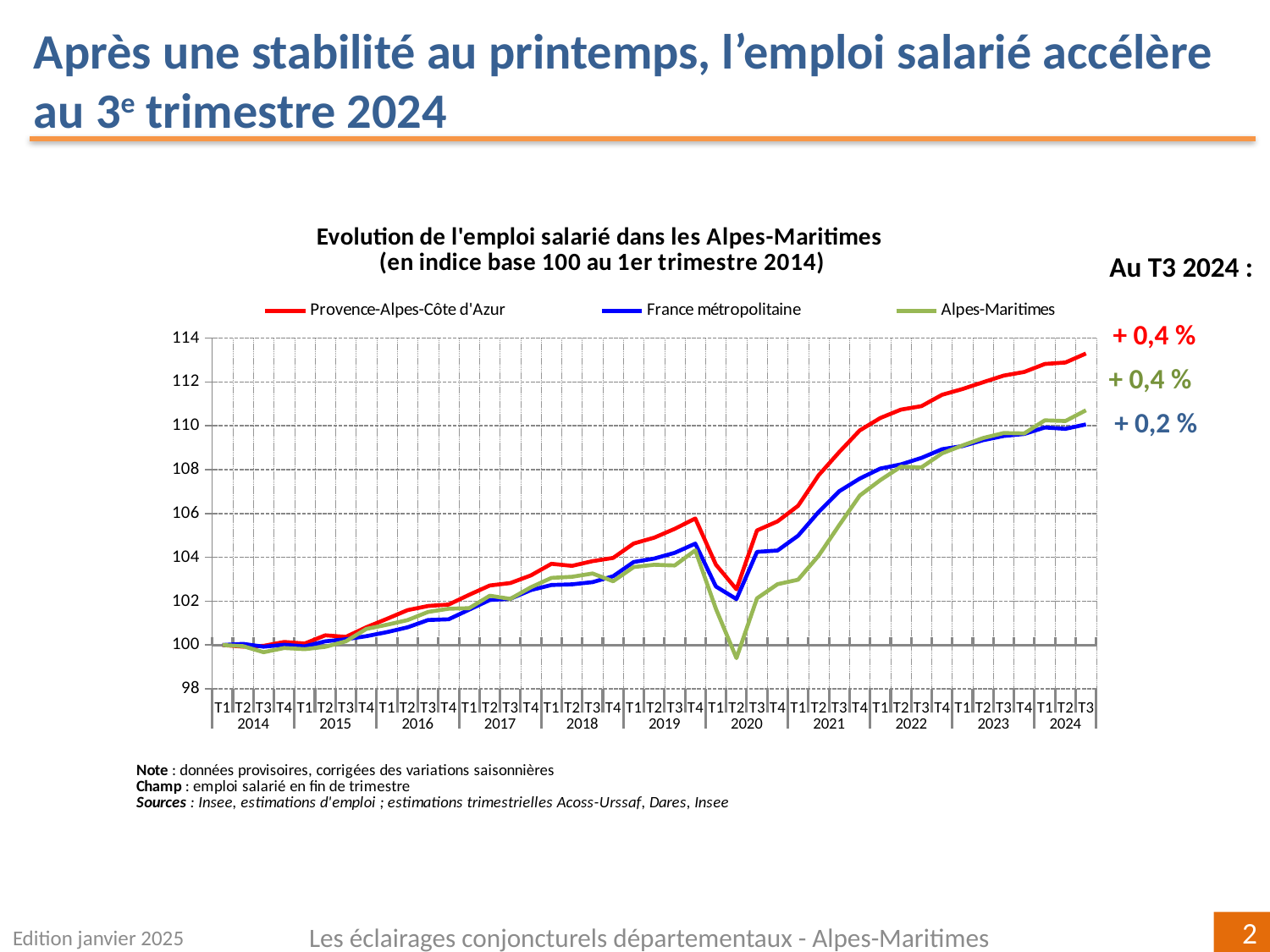
Which series has the lowest index value at T2 2020? Alpes-Maritimes Overall, do the index values rise or fall from T1 2014 to T3 2024? rise What is the base of the index used in the chart, according to its title? base 100 au 1er trimestre 2014 How many series does the legend list? 3 What kind of chart is shown on the slide? line chart What quarterly change is shown for Provence-Alpes-Côte d'Azur at T3 2024? + 0,4 % At T4 2019, which is higher: Provence-Alpes-Côte d'Azur or France métropolitaine? Provence-Alpes-Côte d'Azur Is the value for Provence-Alpes-Côte d'Azur at T3 2024 greater or less than 112? greater What quarterly change is shown for France métropolitaine at T3 2024? + 0,2 % Is the value for Alpes-Maritimes at T2 2020 greater or less than 100? less Which series is drawn in red in the legend? Provence-Alpes-Côte d'Azur Which series has the highest index value at T3 2024? Provence-Alpes-Côte d'Azur